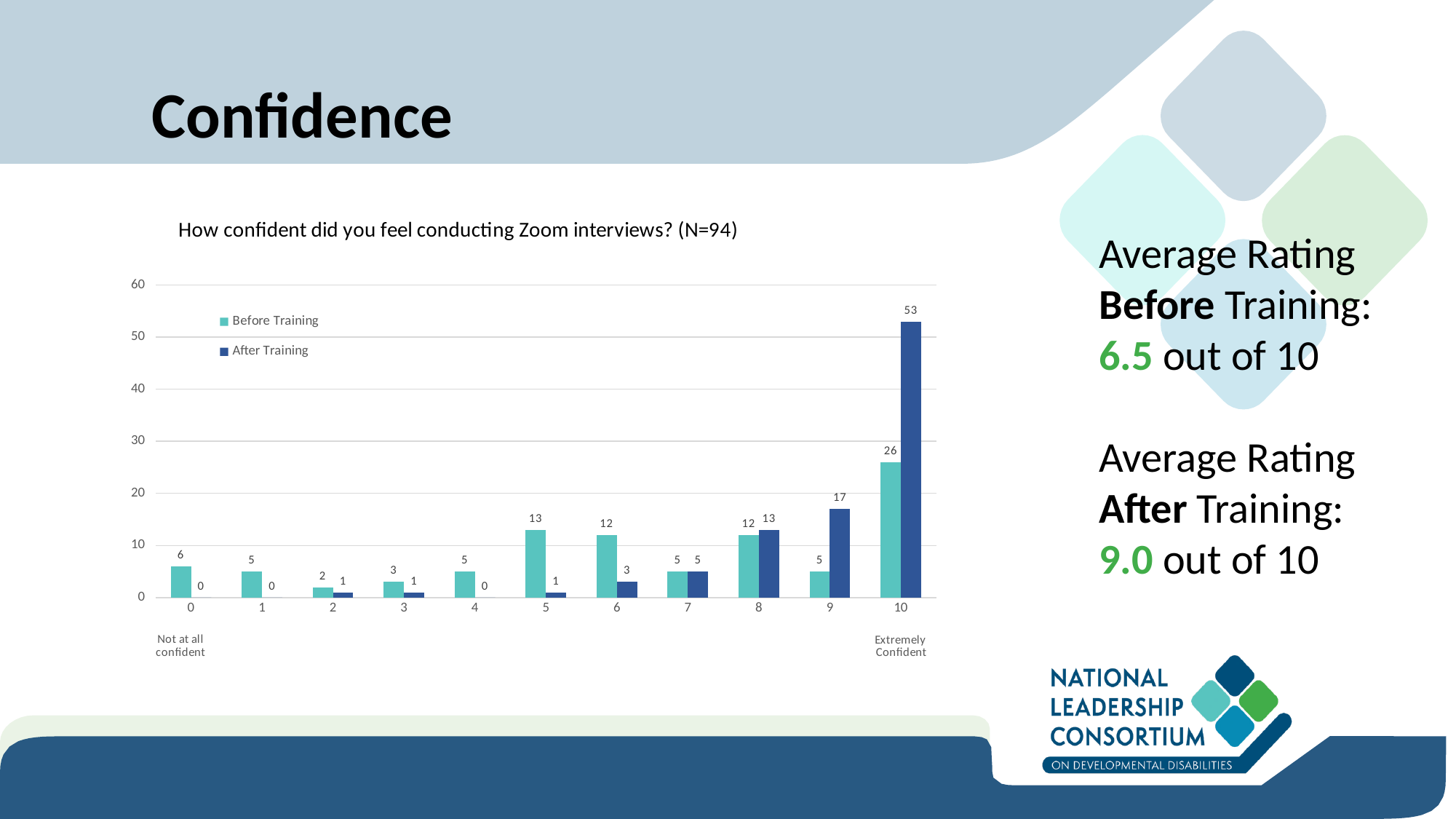
How many rating categories are shown on the x axis? 11 Which is larger for rating 6: the Before Training value or the After Training value? Before Training What is the difference between the After Training and Before Training values for rating 10? 27 Is the After Training value for rating 10 greater or less than 50? greater What kind of chart is shown? Bar chart Which rating has the highest Before Training value? 10 How many series does the legend list? 2 What is the title of the chart? How confident did you feel conducting Zoom interviews? (N=94) What is the After Training value for rating 9? 17 What is the After Training value for rating 10? 53 What is the Before Training value for rating 5? 13 Which rating has the highest After Training value? 10